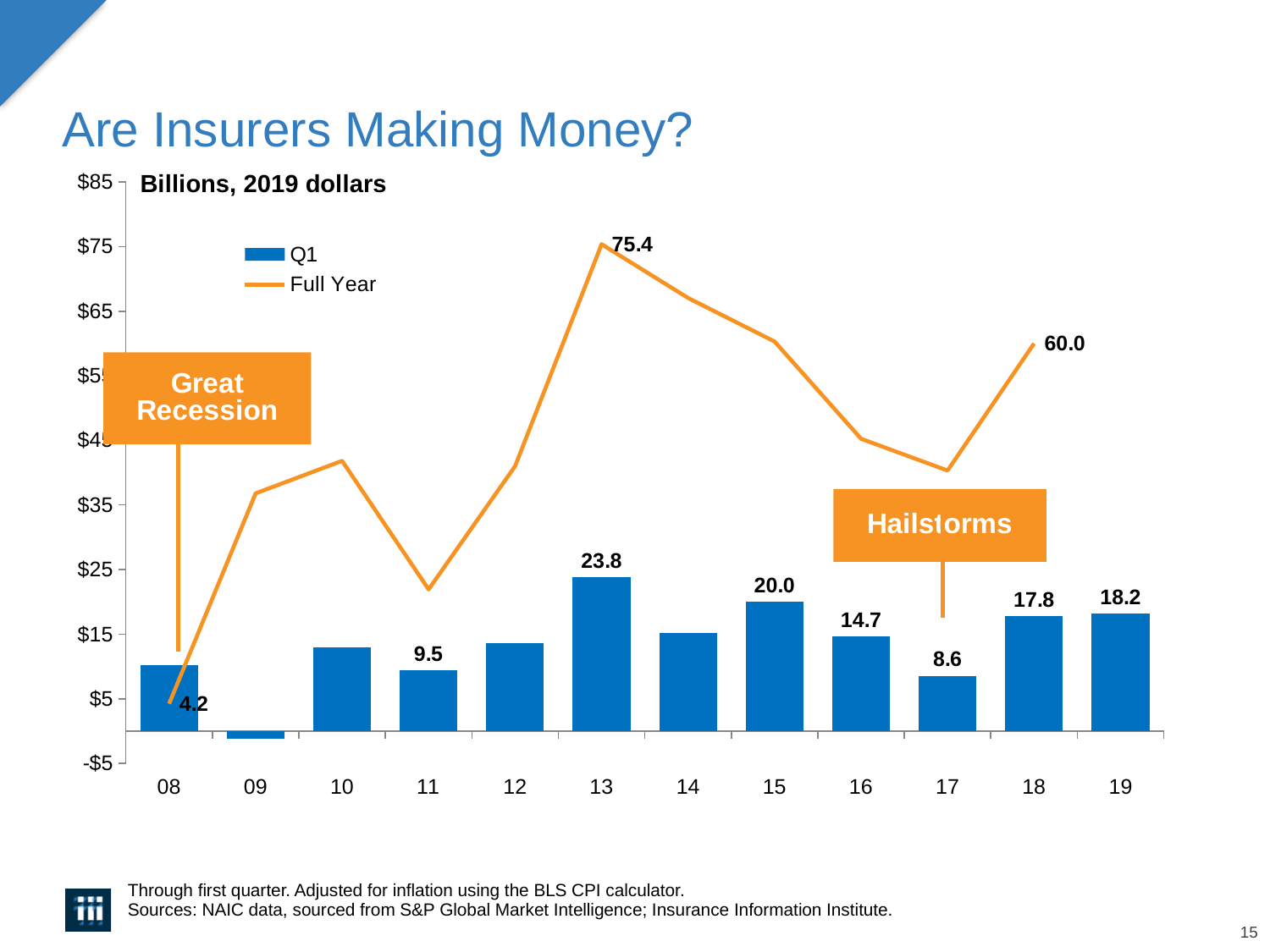
What is the Full Year value for 18? 60.0 How many years are shown on the x axis? 12 How many series does the legend list? 2 Which year has the highest Q1 bar? 13 Does the Full Year line rise or fall from 13 to 17? fall Which year has the lowest Q1 bar? 09 What is the Full Year value for 13? 75.4 What is the Q1 value for 17? 8.6 What is the Q1 value for 13? 23.8 Which is larger, the Q1 value for 16 or for 18? 18 What is the difference between the Q1 values for 15 and 17? 11.4 Is the Full Year value for 09 greater or less than $25? greater